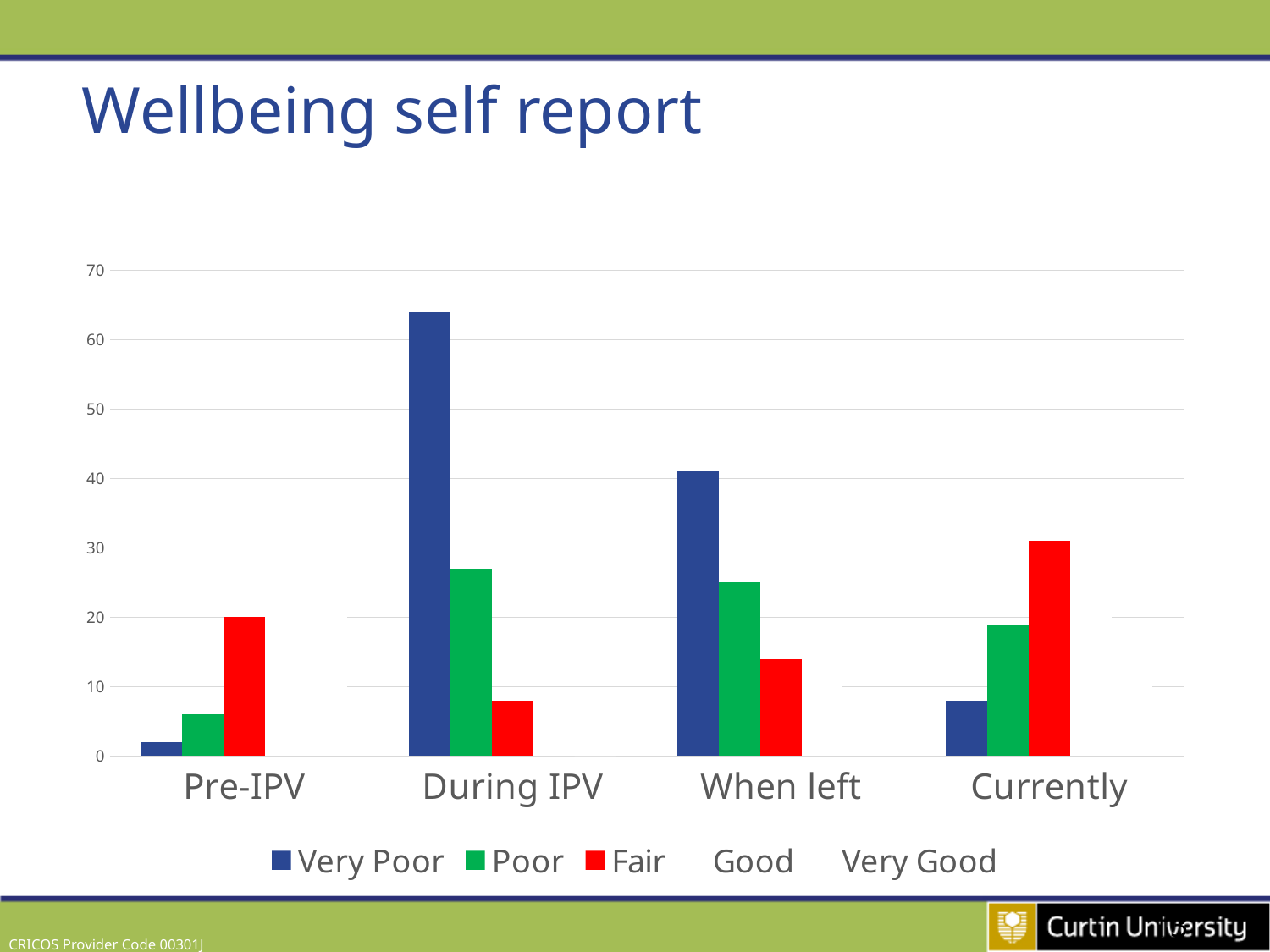
Does the Very Poor value rise or fall from During IPV to Currently? fall In which category is the Very Poor bar the lowest? Pre-IPV Which is larger: the Very Poor value for During IPV or the Very Poor value for When left? During IPV How many series does the legend list? 5 What kind of chart is shown on the slide? bar chart How many categories are shown along the x axis? 4 Is the Very Poor value for When left greater or less than 50? less Is the Very Poor value for During IPV greater or less than 60? greater In the Currently category, which series has the tallest bar? Fair In which category is the Very Poor bar the highest? During IPV Is the Poor value for During IPV greater or less than 20? greater What is the title of the chart? Wellbeing self report